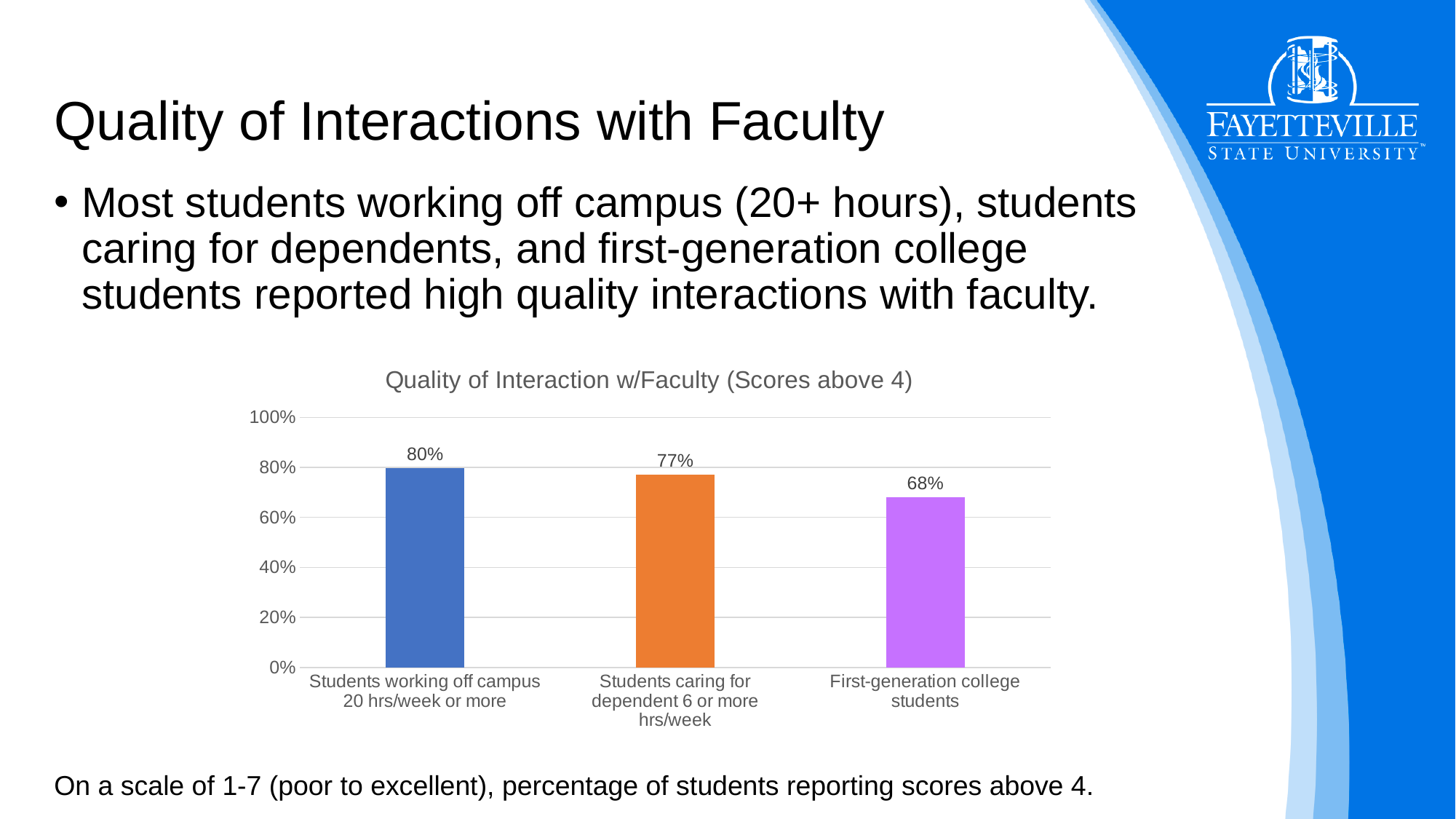
What is the difference between the percentage for students caring for dependent 6 or more hrs/week and first-generation college students? 9% What percentage is shown for students caring for dependent 6 or more hrs/week? 77% What is the difference between the percentage for students working off campus 20 hrs/week or more and first-generation college students? 12% What is the title of the chart? Quality of Interaction w/Faculty (Scores above 4) How many categories are shown in the chart? 3 Which category has the highest percentage? Students working off campus 20 hrs/week or more What percentage is shown for first-generation college students? 68% Which category has the lowest percentage? First-generation college students Is the value for first-generation college students greater or less than 80%? less What kind of chart is shown on the slide? Bar chart What percentage is shown for students working off campus 20 hrs/week or more? 80% Which is larger: the value for students caring for dependent 6 or more hrs/week or for first-generation college students? Students caring for dependent 6 or more hrs/week